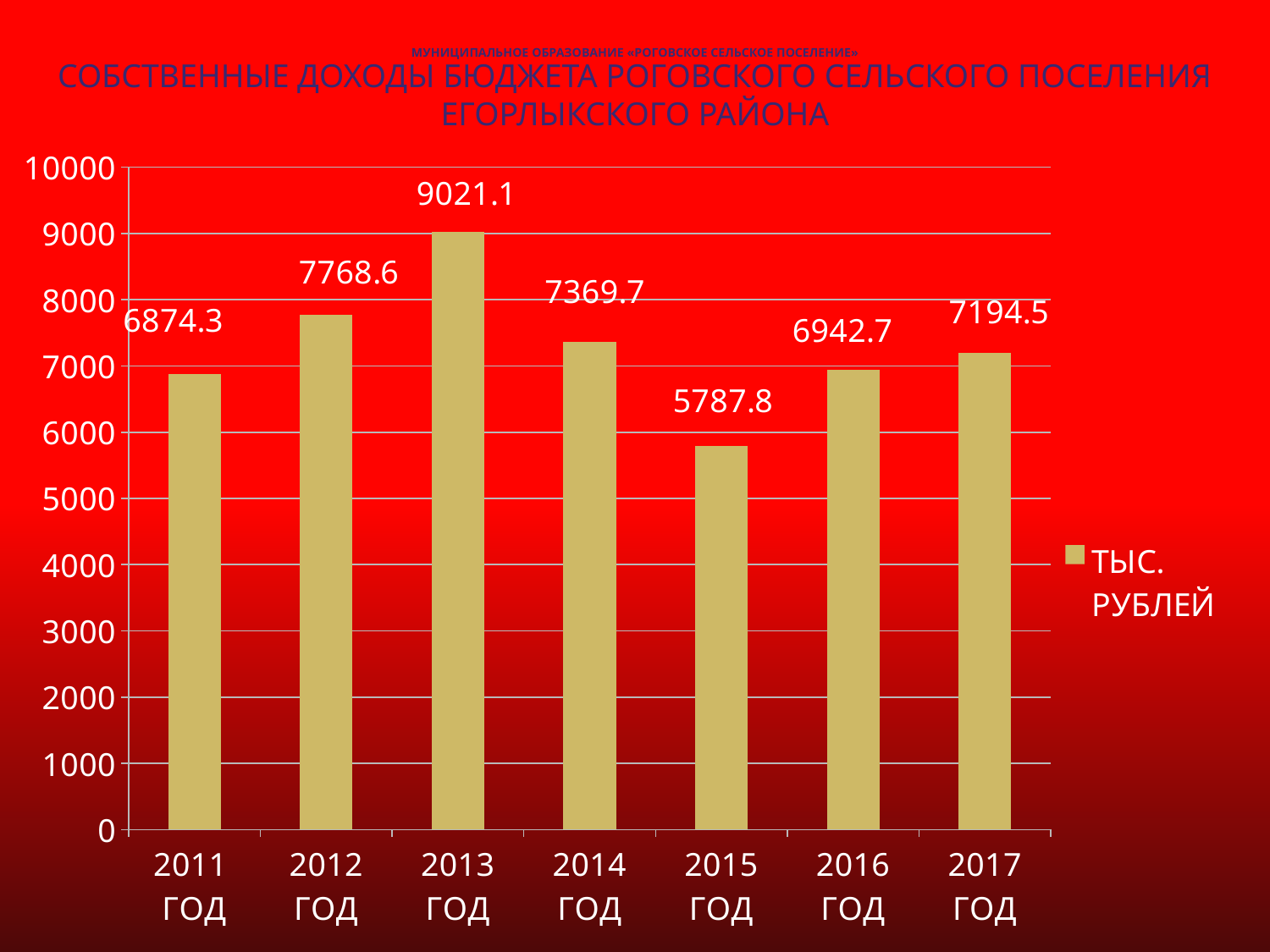
What is the value for 2015 ГОД? 5787.8 Which year has the lowest value? 2015 ГОД Which year has the highest value? 2013 ГОД What is the legend entry for the series? ТЫС. РУБЛЕЙ Is the value for 2016 ГОД greater or less than 7000? less What is the value for 2013 ГОД? 9021.1 What is the difference between the values for 2012 ГОД and 2011 ГОД? 894.3 What is the value for 2011 ГОД? 6874.3 How many years are shown on the x axis? 7 What kind of chart is shown on the slide? bar chart What is the difference between the values for 2013 ГОД and 2015 ГОД? 3233.3 Which is larger, the value for 2014 ГОД or the value for 2017 ГОД? 2014 ГОД